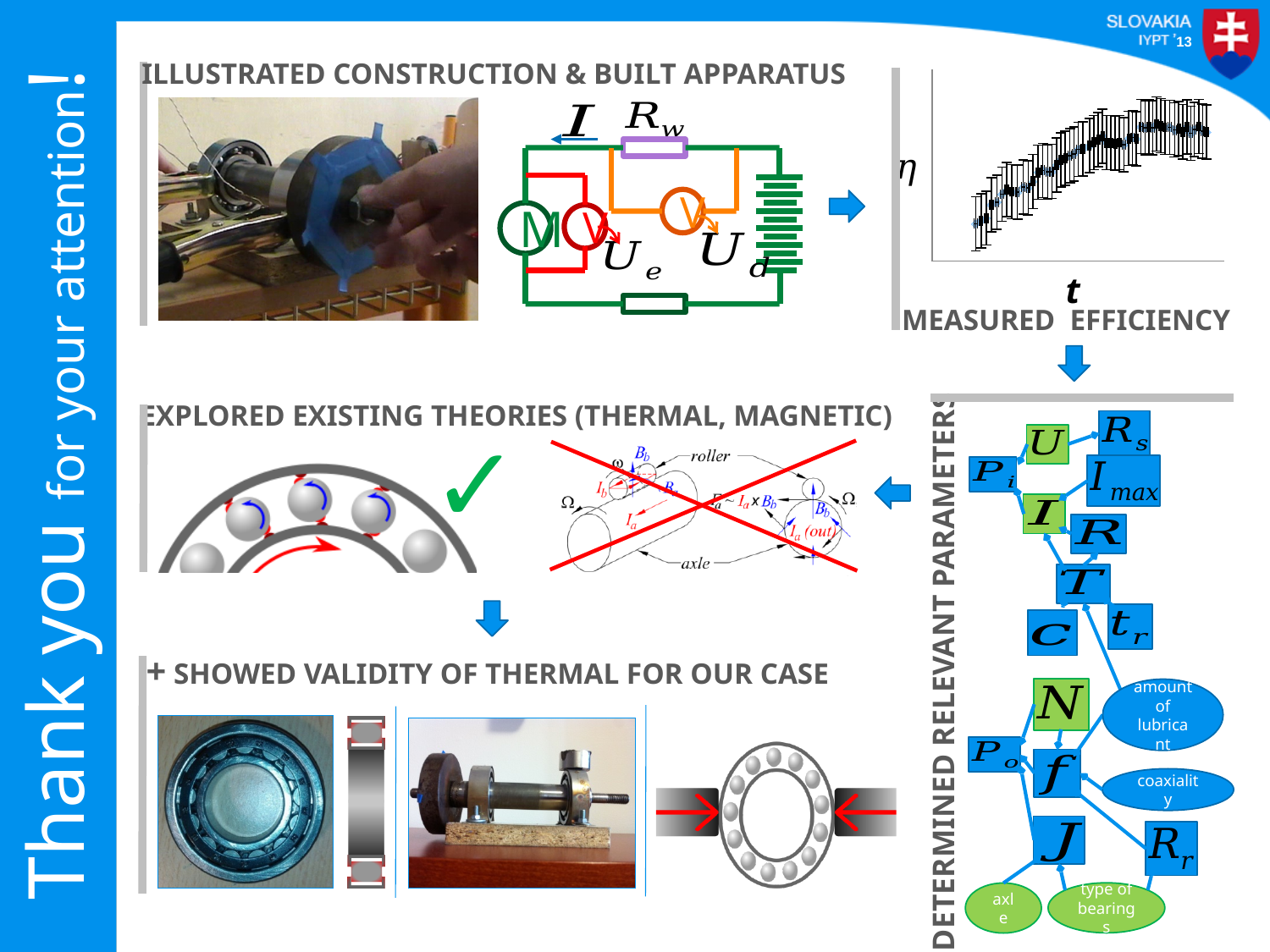
What label is shown on the vertical axis of the 'Measured efficiency' chart? η What kind of chart is the 'Measured efficiency' chart? scatter plot with error bars What is the title of the chart in the top right of the slide? Measured efficiency In the 'Measured efficiency' chart, do the plotted values rise or fall as t increases? rise